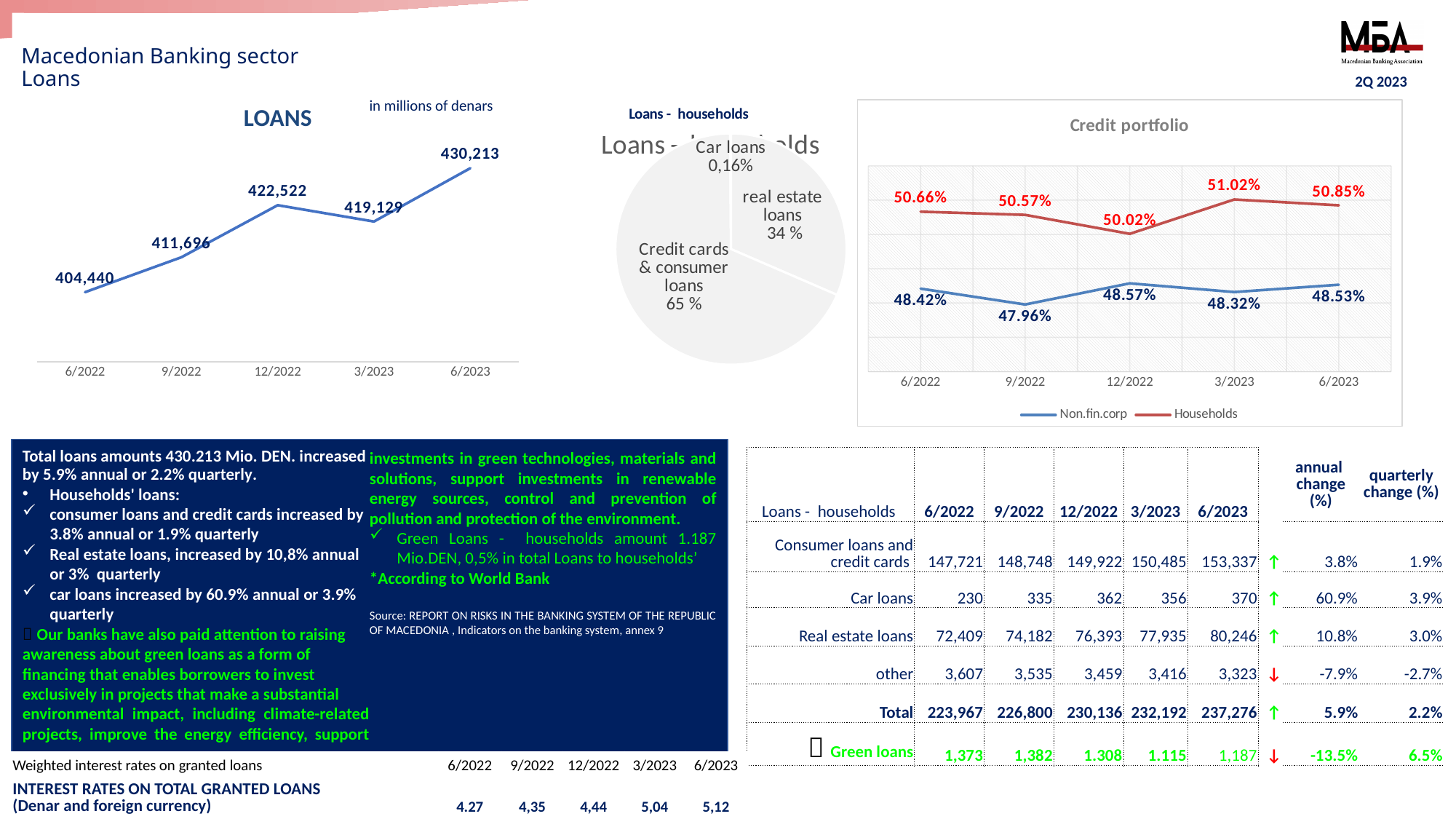
In the LOANS chart, what is the value for 3/2023? 419,129 In the Credit portfolio chart, what is the Households value for 3/2023? 51.02% In the LOANS chart, which is larger: the value for 12/2022 or the value for 3/2023? 12/2022 In the Loans - households pie chart, what share do real estate loans have? 34 % How many data points are plotted in the LOANS chart? 5 In the LOANS chart, what is the value for 6/2023? 430,213 In the Loans - households pie chart, which slice is the smallest? Car loans In the LOANS chart, which period has the lowest value? 6/2022 What type of chart is the LOANS chart? line chart In the Credit portfolio chart, which period has the lowest Non.fin.corp value? 9/2022 How many series does the legend of the Credit portfolio chart list? 2 In the LOANS chart, what is the difference between the values for 6/2023 and 6/2022? 25,773